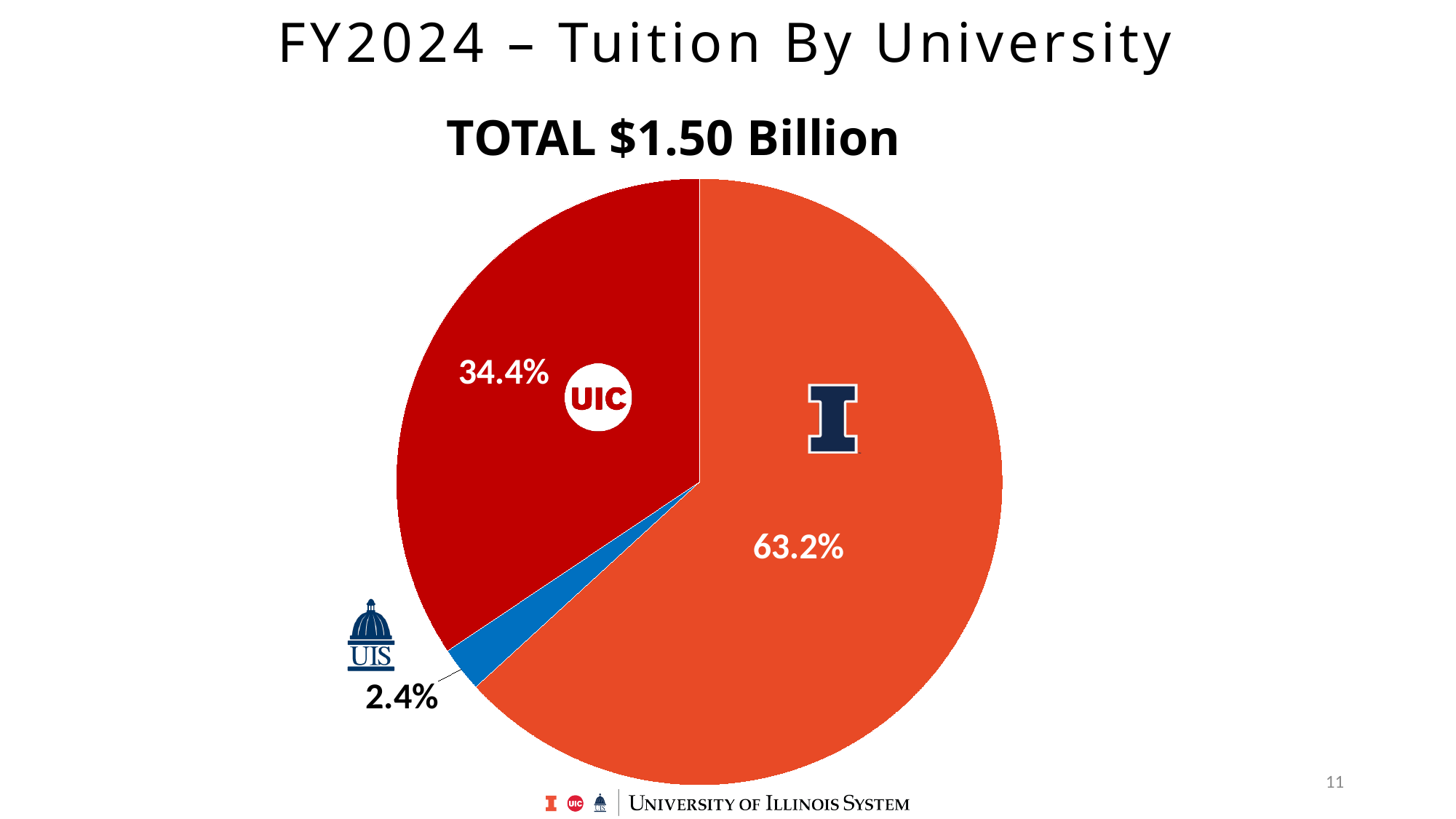
What share of tuition does the UIC slice represent? 34.4% Which university has the smallest share of tuition in the pie chart? UIS What share of tuition does the UIS slice represent? 2.4% What share of tuition does the orange slice with the Block I logo represent? 63.2% Which has a larger share of tuition, UIC or UIS? UIC Which slice of the pie chart is the largest? the orange Block I slice (63.2%) What is the title of the slide? FY2024 – Tuition By University How many slices does the pie chart have? 3 How many percentage points larger is the UIC slice than the UIS slice? 32.0 percentage points How many percentage points larger is the Block I slice (63.2%) than the UIC slice (34.4%)? 28.8 percentage points What kind of chart is shown on the slide? pie chart What total amount is shown above the pie chart? $1.50 Billion